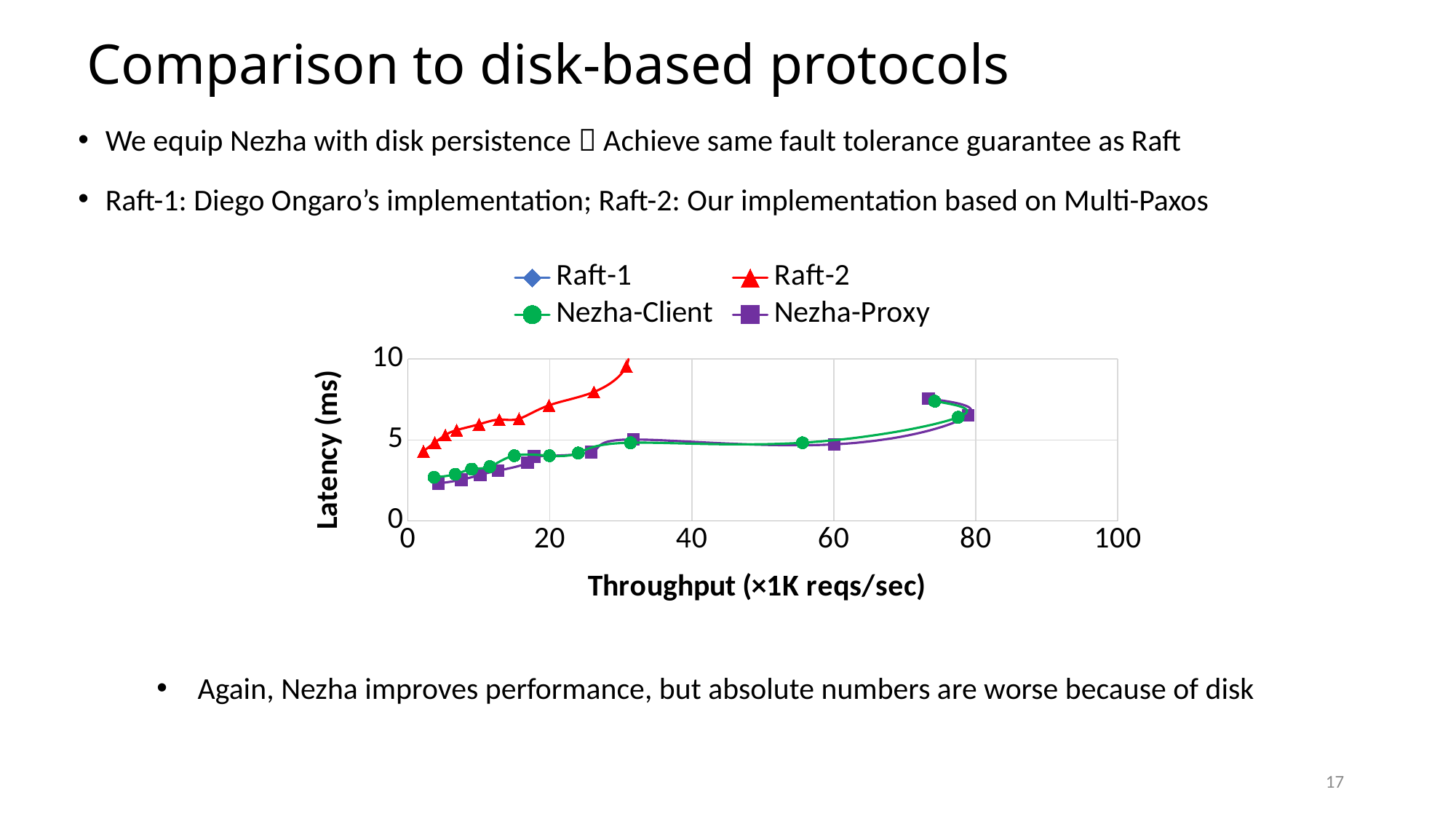
Is the maximum throughput reached by Nezha-Proxy greater or less than 60 (×1K reqs/sec)? greater Is the highest latency reached by Raft-2 greater or less than 5 ms? greater Is the latency of the first (lowest-throughput) Nezha-Client point greater or less than 5 ms? less Which series reaches a higher maximum throughput, Raft-2 or Nezha-Proxy? Nezha-Proxy At a throughput of about 20 (×1K reqs/sec), which series has the higher latency, Raft-2 or Nezha-Client? Raft-2 What is the label of the y axis? Latency (ms) Does the latency of Raft-2 rise or fall as throughput increases? rise What kind of chart is shown on the slide? line chart How many series does the legend list? 4 What is the label of the x axis? Throughput (×1K reqs/sec)